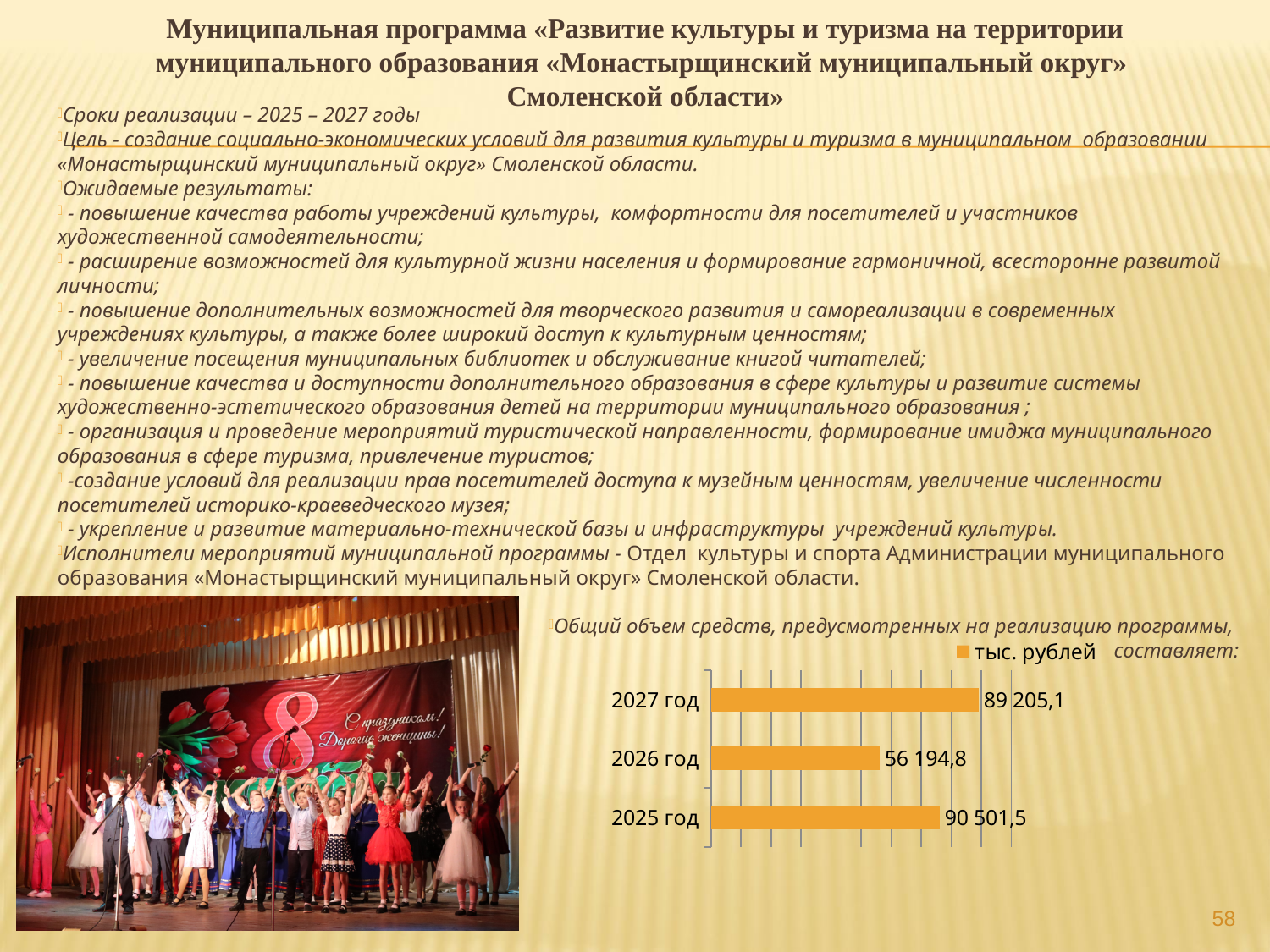
Which year has the lowest value? 2026 год Which is larger, the value for 2027 год or the value for 2026 год? 2027 год How many series does the legend list? 1 What is the difference between the values for 2027 год and 2026 год? 33 010,3 What is the difference between the values for 2025 год and 2026 год? 34 306,7 How many years are shown in the chart? 3 What kind of chart is shown on the slide? bar chart What is the legend entry of the chart? тыс. рублей What is the value for 2025 год? 90 501,5 What is the value for 2027 год? 89 205,1 What is the value for 2026 год? 56 194,8